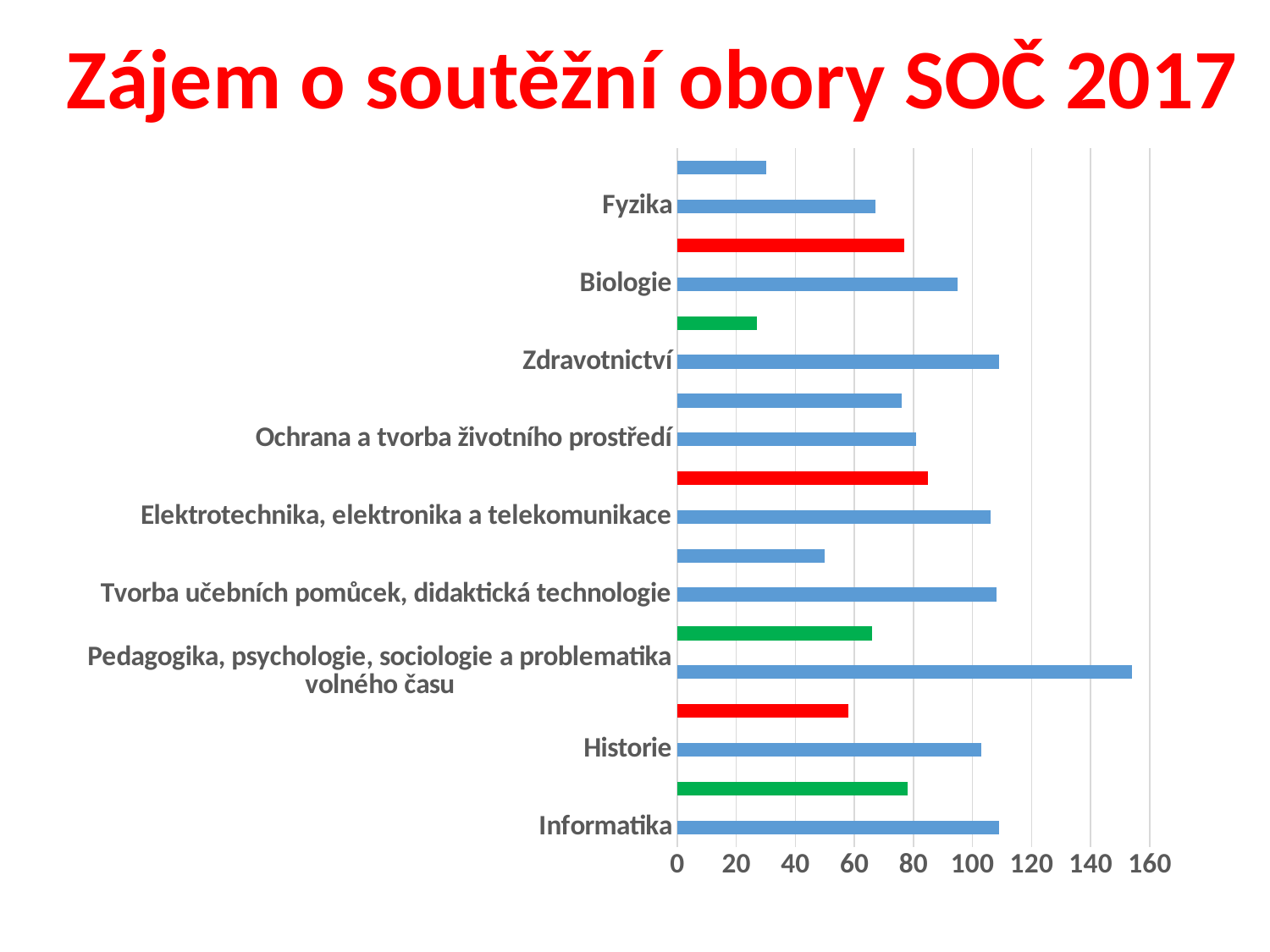
What is the title of the slide? Zájem o soutěžní obory SOČ 2017 Is the value for Zdravotnictví greater or less than 100? greater Which labelled category has the longest bar? Pedagogika, psychologie, sociologie a problematika volného času Is the value for Pedagogika, psychologie, sociologie a problematika volného času greater or less than 140? greater Is the value for Fyzika greater or less than 80? less Which has the larger value, Fyzika or Biologie? Biologie Which has the larger value, Ochrana a tvorba životního prostředí or Elektrotechnika, elektronika a telekomunikace? Elektrotechnika, elektronika a telekomunikace What is the highest value shown on the horizontal axis? 160 What kind of chart is shown on the slide? bar chart